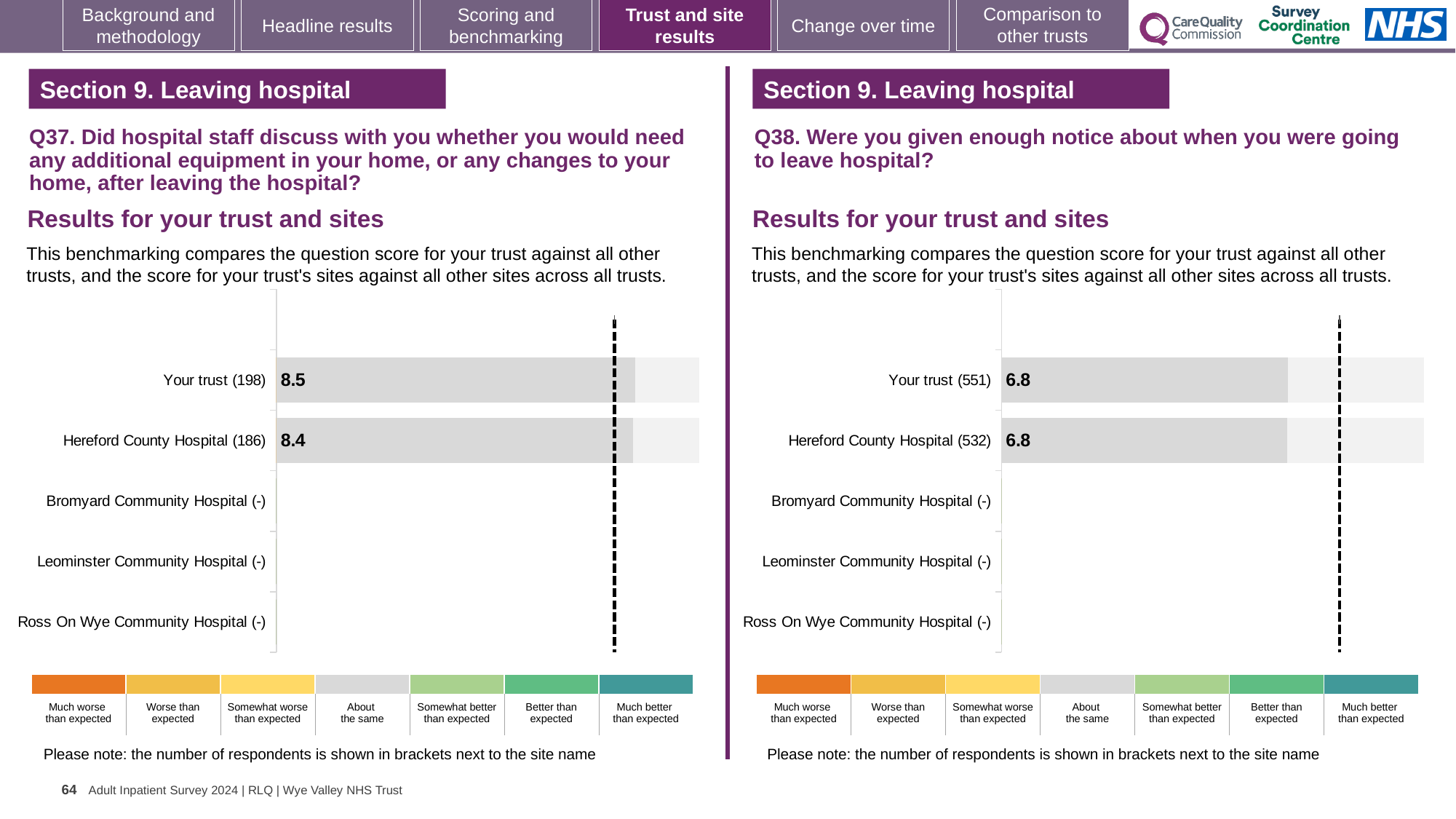
In the Q37 chart on the left, what is the difference between the score for Your trust and the score for Hereford County Hospital? 0.1 In the Q37 chart on the left, which has the higher score, Your trust or Hereford County Hospital? Your trust In the Q38 chart on the right, what is the score for Hereford County Hospital (532)? 6.8 What kind of chart is used for the Q37 results on the left? Bar chart In the Q38 chart on the right, what is the score for Your trust (551)? 6.8 In the Q38 chart on the right, what is the difference between the score for Your trust and the score for Hereford County Hospital? 0 In the Q37 chart on the left, what is the score for Your trust (198)? 8.5 How many respondents are shown in brackets for Your trust in the Q38 chart on the right? 551 In the Q37 chart on the left, what is the score for Hereford County Hospital (186)? 8.4 How many site/trust categories are listed on the y axis of the Q37 chart on the left? 5 In the Q38 chart on the right, how many categories have a plotted bar with a score? 2 How many benchmark categories does the colour key below the Q37 chart on the left show? 7